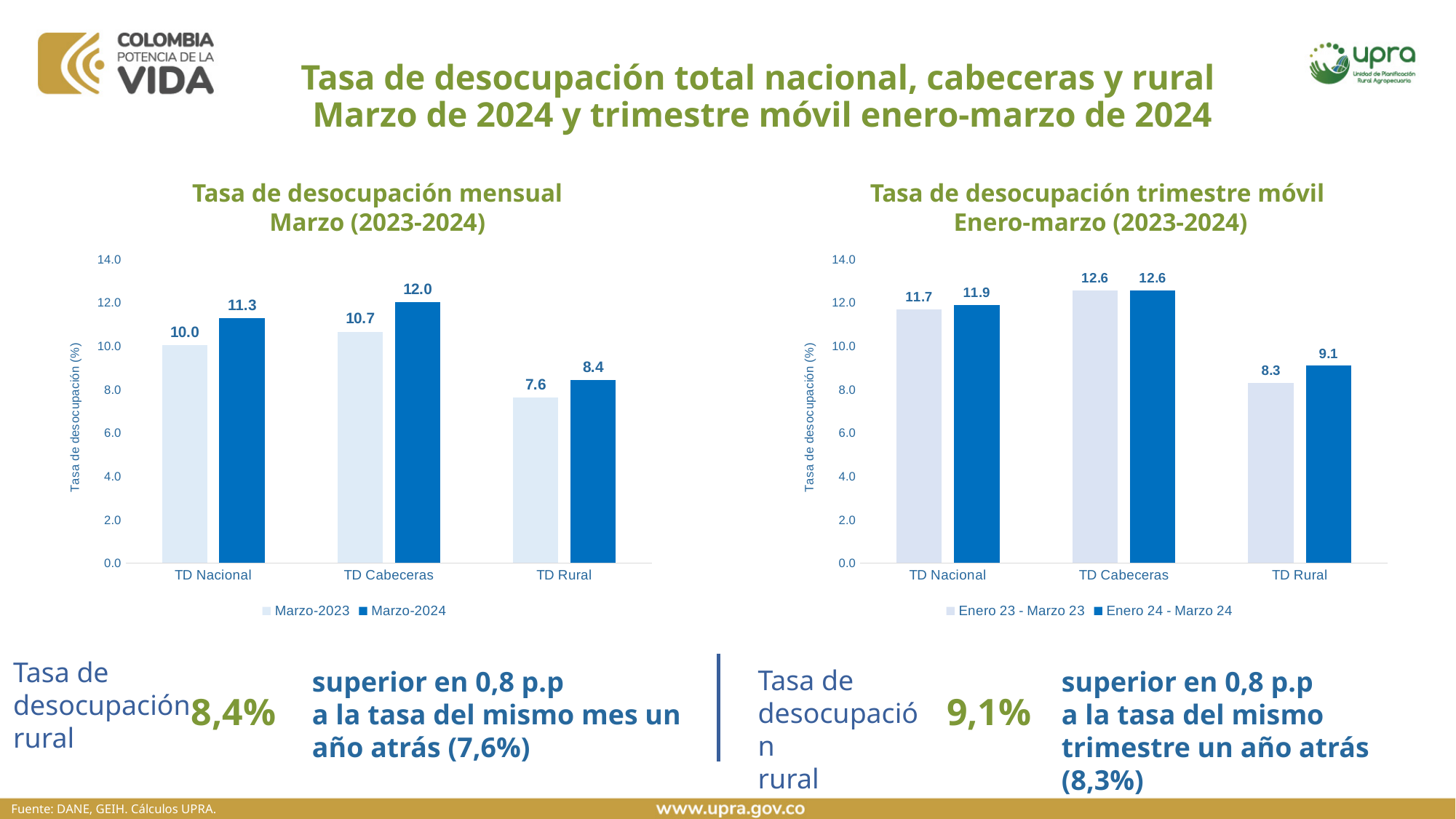
In the 'Tasa de desocupación mensual Marzo (2023-2024)' chart, what is the value for TD Rural in Marzo-2023? 7.6 In the 'Tasa de desocupación trimestre móvil Enero-marzo (2023-2024)' chart, which category has the lowest value for Enero 23 - Marzo 23? TD Rural In the 'Tasa de desocupación mensual Marzo (2023-2024)' chart, how many series does the legend list? 2 In the 'Tasa de desocupación trimestre móvil Enero-marzo (2023-2024)' chart, what is the value for TD Cabeceras in Enero 23 - Marzo 23? 12.6 In the 'Tasa de desocupación mensual Marzo (2023-2024)' chart, what is the difference between the Marzo-2024 and Marzo-2023 values for TD Cabeceras? 1.3 In the 'Tasa de desocupación trimestre móvil Enero-marzo (2023-2024)' chart, what is the value for TD Rural in Enero 24 - Marzo 24? 9.1 In the 'Tasa de desocupación trimestre móvil Enero-marzo (2023-2024)' chart, how many categories are shown on the x axis? 3 In the 'Tasa de desocupación mensual Marzo (2023-2024)' chart, what is the value for TD Nacional in Marzo-2024? 11.3 In the 'Tasa de desocupación mensual Marzo (2023-2024)' chart, which is larger: the Marzo-2024 value for TD Nacional or the Marzo-2023 value for TD Cabeceras? Marzo-2024 value for TD Nacional What kind of chart is the 'Tasa de desocupación mensual Marzo (2023-2024)' chart? Bar chart In the 'Tasa de desocupación trimestre móvil Enero-marzo (2023-2024)' chart, what is the difference between the Enero 24 - Marzo 24 and Enero 23 - Marzo 23 values for TD Nacional? 0.2 In the 'Tasa de desocupación mensual Marzo (2023-2024)' chart, which category has the highest value for Marzo-2024? TD Cabeceras